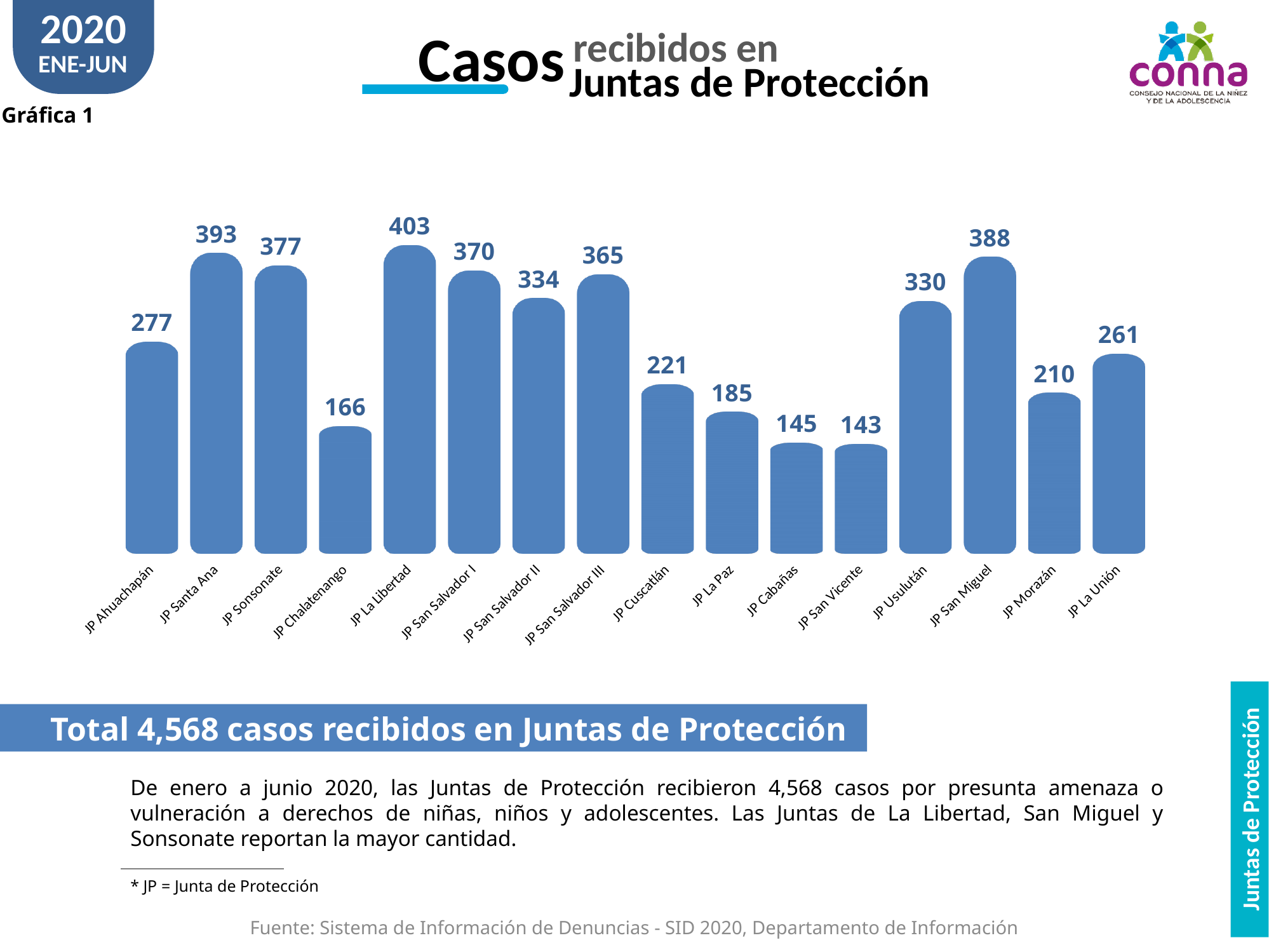
What total number of cases received in Juntas de Protección is stated on the slide? 4,568 What is the value shown for JP Morazán? 210 How many cases were received by JP La Libertad? 403 Which Junta de Protección has the highest number of cases? JP La Libertad Which has a larger value, JP Cuscatlán or JP La Paz? JP Cuscatlán What type of chart is shown on the slide? Bar chart How many Juntas de Protección (bars) are shown in the chart? 16 What is the difference between the values for JP Santa Ana and JP Sonsonate? 16 What is the difference between the values for JP San Miguel and JP Usulután? 58 Which Junta de Protección has the lowest number of cases? JP San Vicente Which has a larger value, JP Ahuachapán or JP La Unión? JP Ahuachapán What is the value shown for JP Cabañas? 145